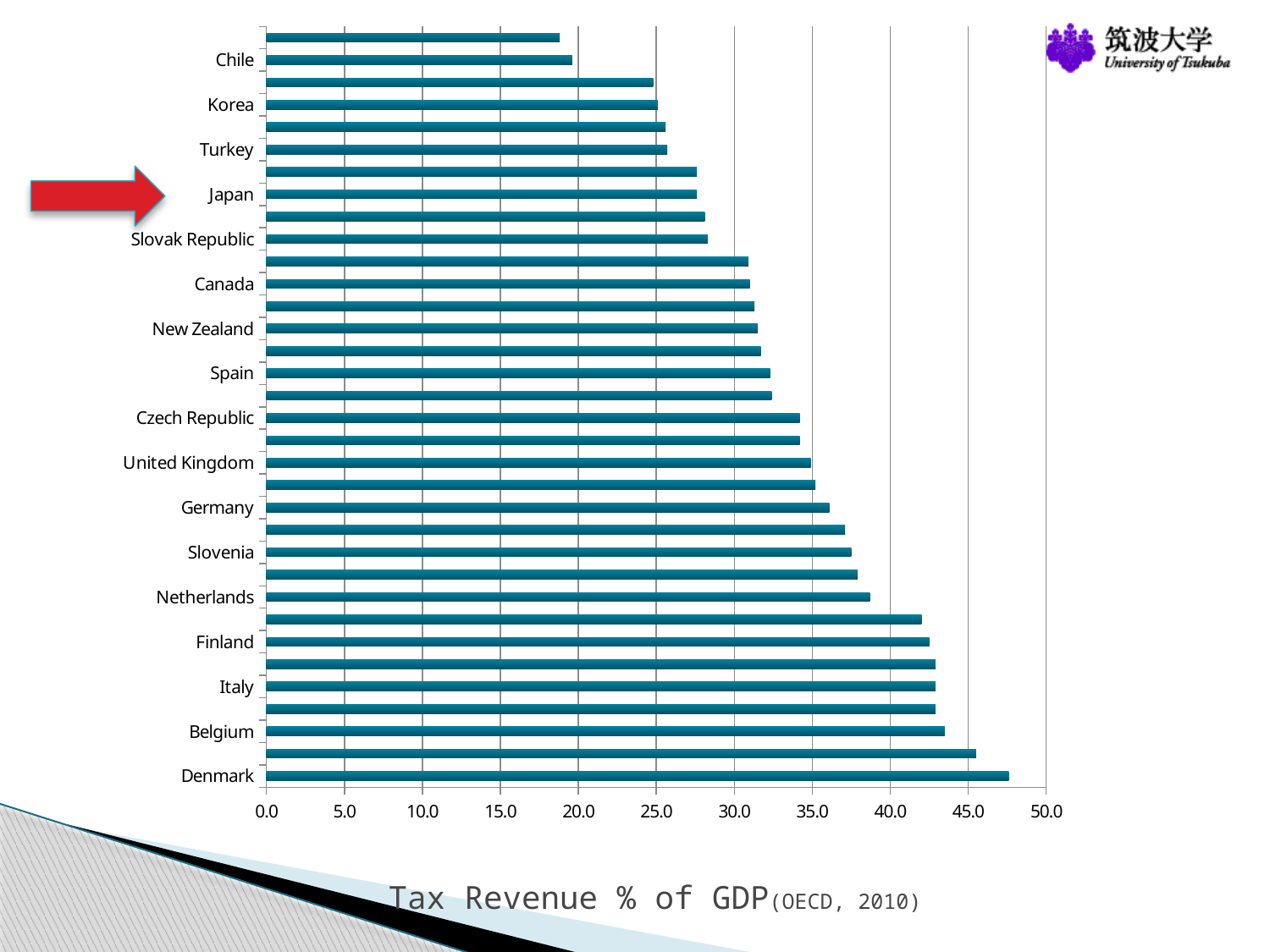
Among the labeled countries, which has the shortest bar? Chile Do the bar values increase or decrease going from the top of the chart to the bottom? increase Is the value for Netherlands greater or less than 40.0? less Which has the larger value, Germany or Japan? Germany Is the value for Chile greater or less than 20.0? less Is the value for Denmark greater or less than 45.0? greater What kind of chart is shown on the slide? bar chart Which country does the red arrow point to? Japan What is the title of the chart? Tax Revenue % of GDP (OECD, 2010) Which country has the longest bar in the chart? Denmark